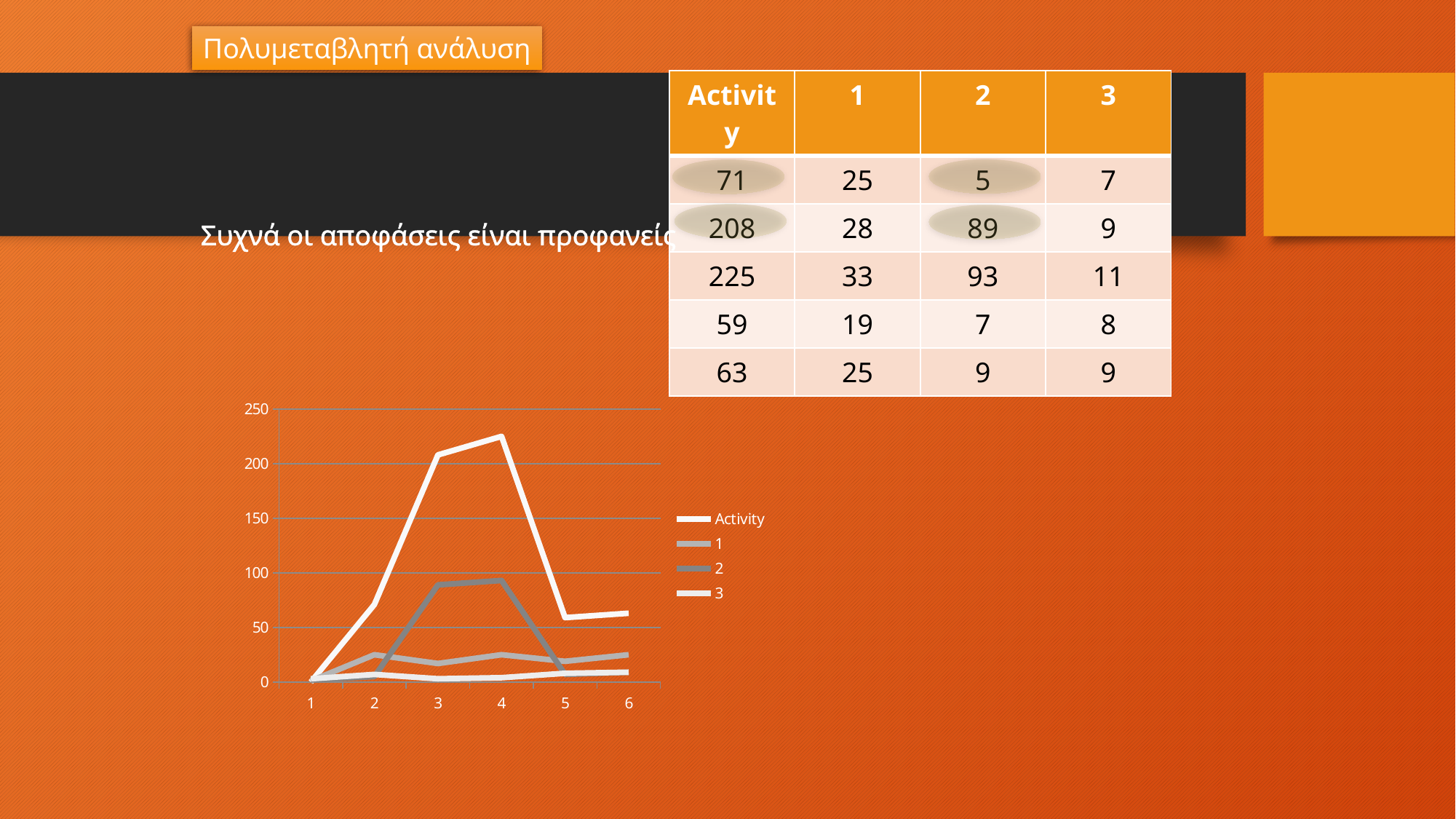
How many series does the chart's legend list? 4 What kind of chart is shown on the slide? line chart Is the value of series 2 at x = 4 greater or less than 100? less What is the highest value shown on the chart's y axis? 250 Is the value of series 3 at x = 4 greater or less than 50? less At which x-axis point does the Activity series reach its highest value? 4 How many points are labelled along the x axis of the chart? 6 Is the value of the Activity series at x = 4 greater or less than 200? greater Does the Activity series rise or fall between x = 4 and x = 5? fall At which x-axis point is the Activity series at its lowest value? 1 At x = 4, which series has the larger value, Activity or 2? Activity